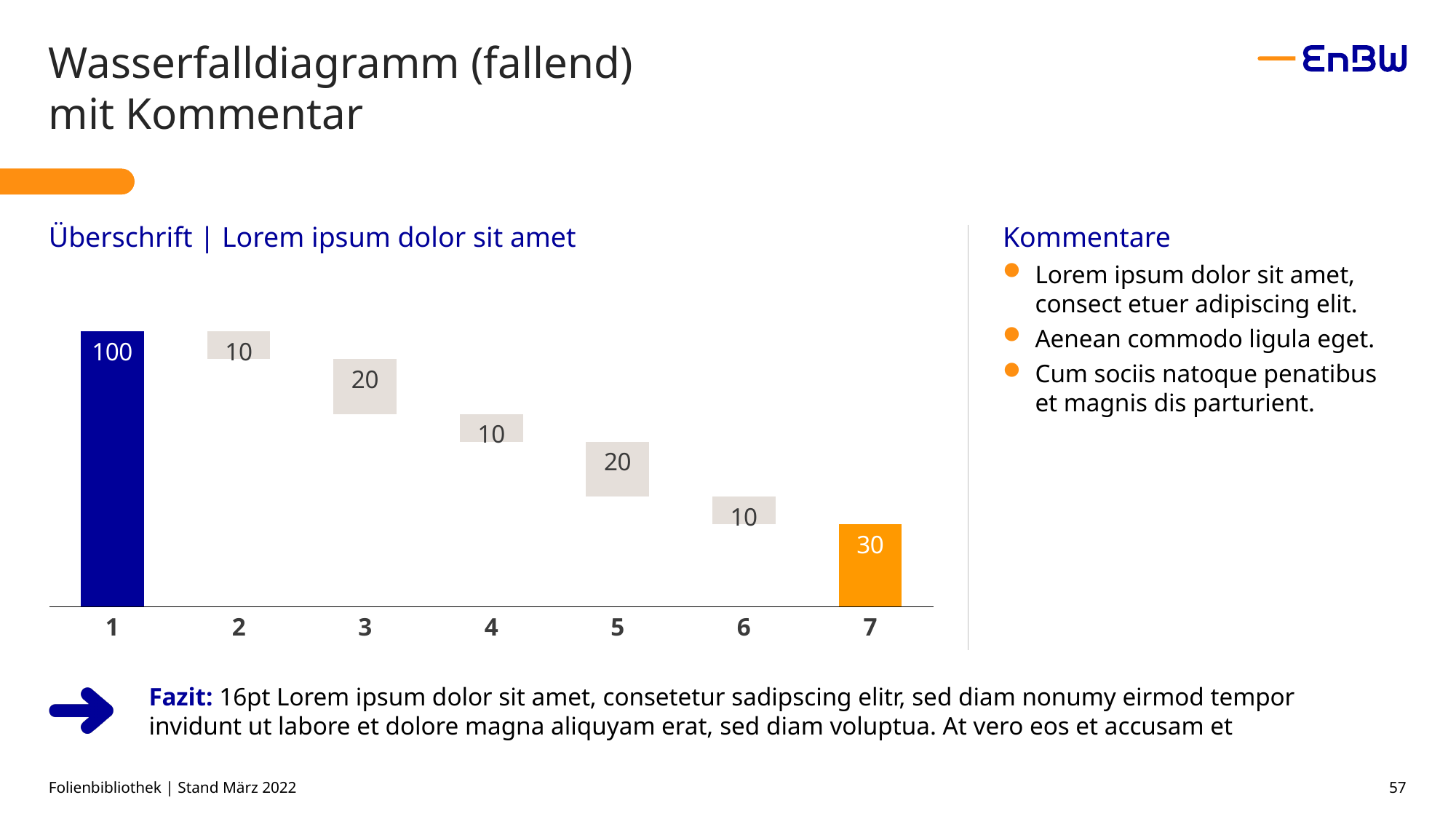
What is the title of the chart? Überschrift | Lorem ipsum dolor sit amet What is the value shown for category 6? 10 What is the value shown for category 7? 30 What is the difference between the values for category 1 and category 7? 70 How many categories are shown on the x axis? 7 What is the value shown for category 3? 20 What is the value shown for category 1? 100 Which category has the highest value? 1 What colour is the bar for category 7? orange Which is larger, the value for category 5 or the value for category 6? category 5 What kind of chart is shown on the slide? waterfall chart What is the difference between the values for category 3 and category 2? 10